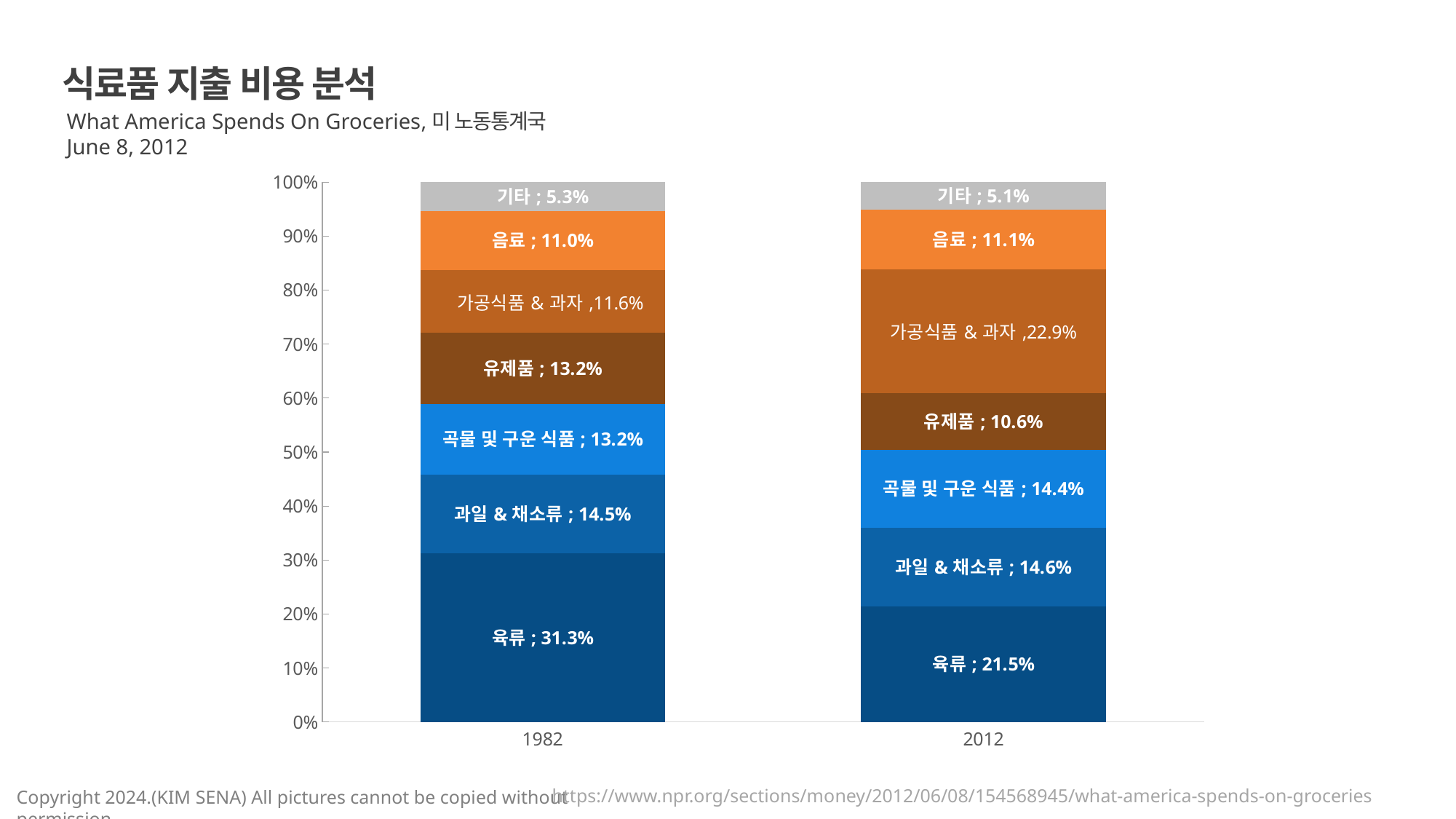
Did the share for 유제품 rise or fall from 1982 to 2012? fall Which category has the largest share in the 1982 bar? 육류 By how many percentage points did the 육류 share fall from 1982 to 2012? 9.8 Which is larger in 2012: the share for 육류 or the share for 가공식품 & 과자? 가공식품 & 과자 How many years (bars) are shown on the x axis? 2 By how many percentage points did the 가공식품 & 과자 share rise from 1982 to 2012? 11.3 Which category has the smallest share in the 2012 bar? 기타 What share of grocery spending did 육류 account for in 1982? 31.3% What share of grocery spending did 가공식품 & 과자 account for in 2012? 22.9% What is the value for 음료 in the 1982 bar? 11.0% What is the value for 유제품 in the 2012 bar? 10.6% What kind of chart is shown on the slide? stacked bar chart